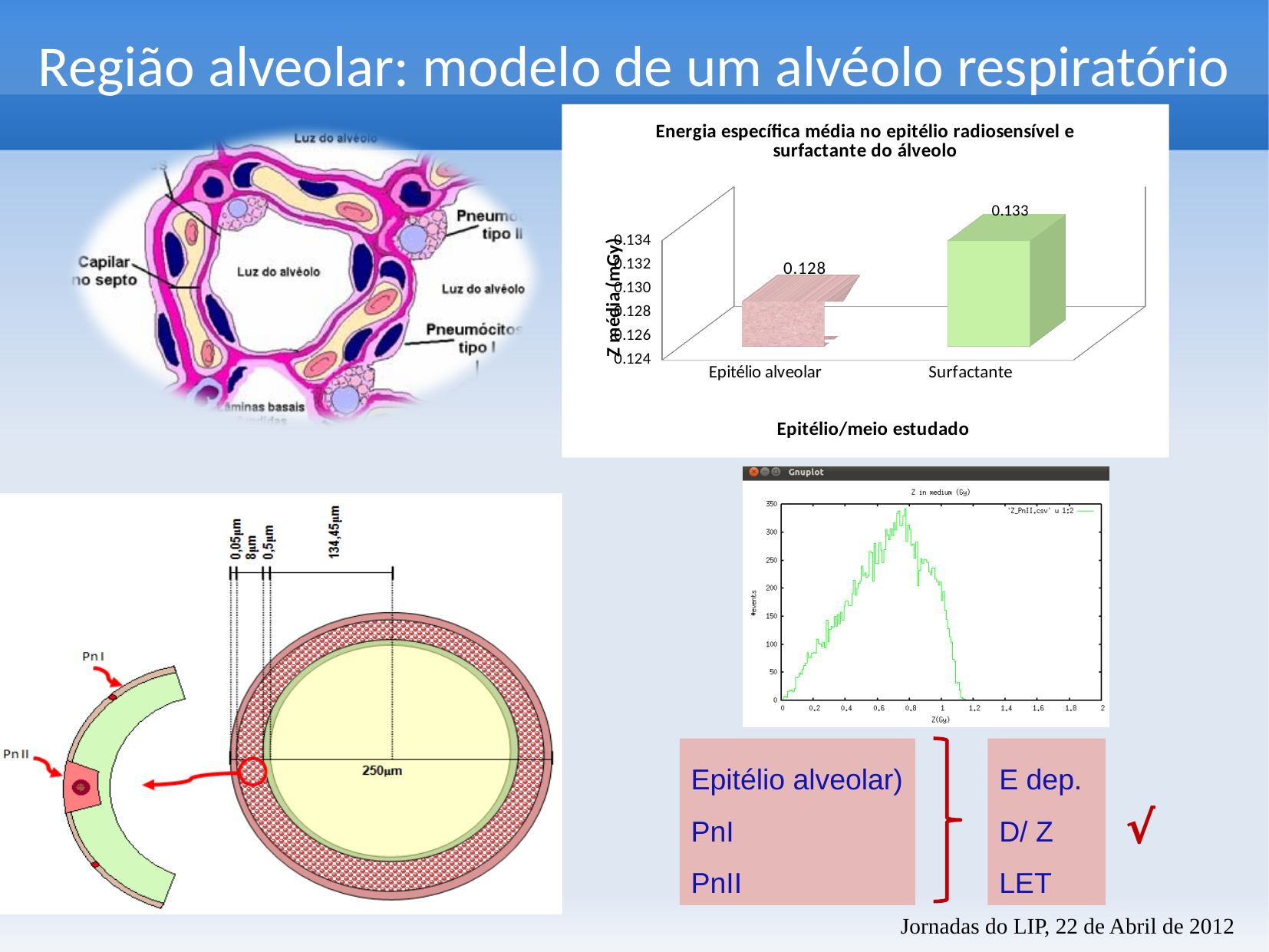
In the bar chart at the top right of the slide, what is the difference between the values for Surfactante and Epitélio alveolar? 0.005 In the chart titled 'Energia específica média no epitélio radiosensível e surfactante do álveolo', what is the value for Surfactante? 0.133 How many categories are shown in the bar chart at the top right of the slide? 2 What is the y-axis label of the bar chart at the top right of the slide? Z média (mGy) In the bar chart at the top right of the slide, is the value for Surfactante greater or less than 0.130? greater What is the x-axis label of the bar chart at the top right of the slide? Epitélio/meio estudado In the Gnuplot chart titled 'Z in medium (Gy)', is the peak value of the curve greater or less than 300? greater In the bar chart at the top right of the slide, which category has the highest value? Surfactante What kind of chart is the chart titled 'Energia específica média no epitélio radiosensível e surfactante do álveolo'? bar chart In the bar chart at the top right of the slide, which category has the lowest value? Epitélio alveolar In the bar chart at the top right of the slide, which is larger: the value for Epitélio alveolar or the value for Surfactante? Surfactante In the chart titled 'Energia específica média no epitélio radiosensível e surfactante do álveolo', what is the value for Epitélio alveolar? 0.128